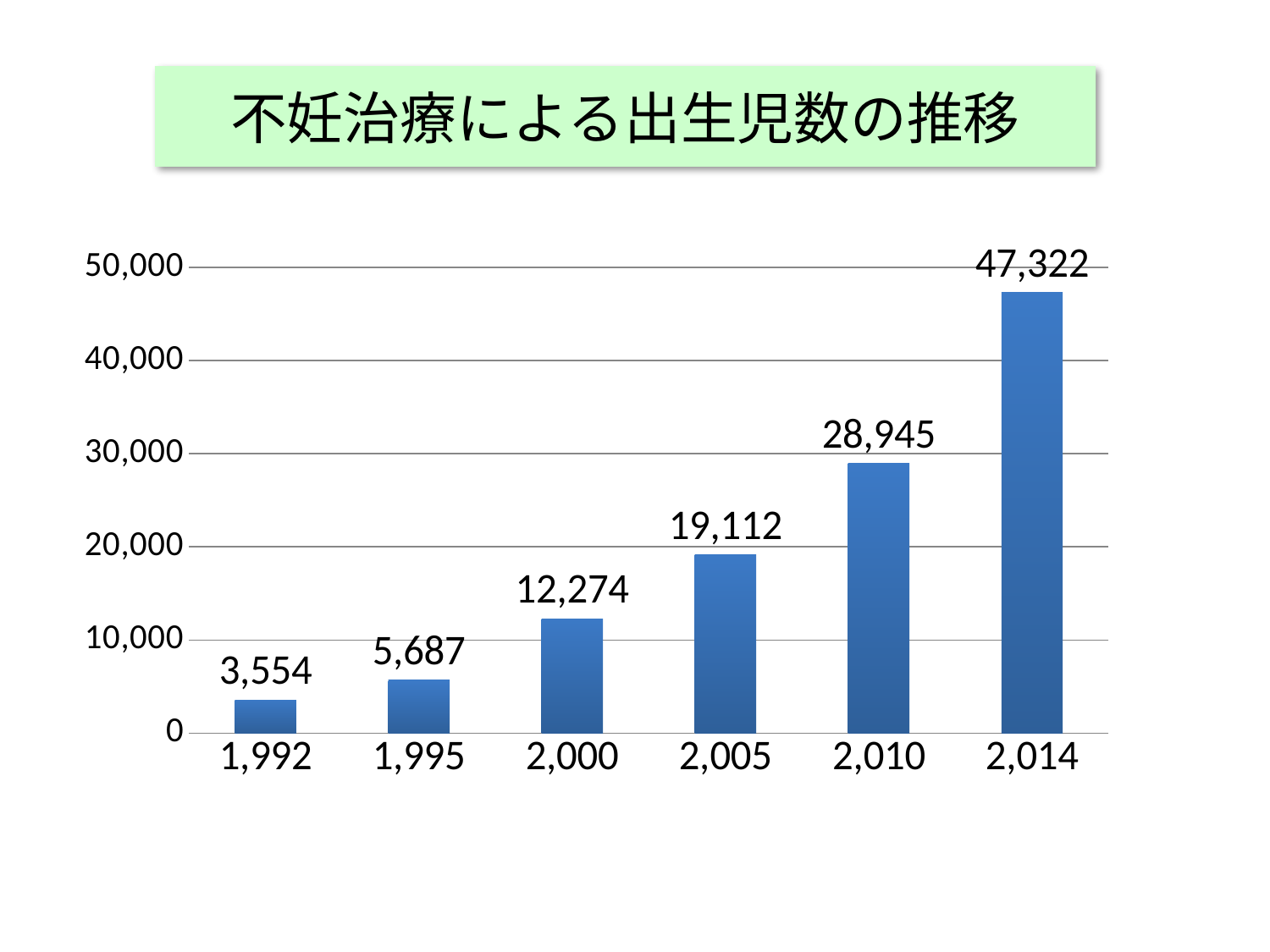
What is the difference between the values for 1,995 and 1,992? 2,133 Do the values rise or fall from left to right along the x axis? rise Which is larger, the value for 2,000 or the value for 2,005? 2,005 What is the value shown for the category labelled 1,992? 3,554 What is the value shown for the category labelled 2,010? 28,945 Is the value for 2,010 greater or less than 30,000? less What is the value shown for the category labelled 2,005? 19,112 How many categories are shown on the x axis? 6 What kind of chart is shown on the slide? bar chart Which category has the highest value? 2,014 What is the difference between the values for 2,014 and 2,010? 18,377 Which category has the lowest value? 1,992